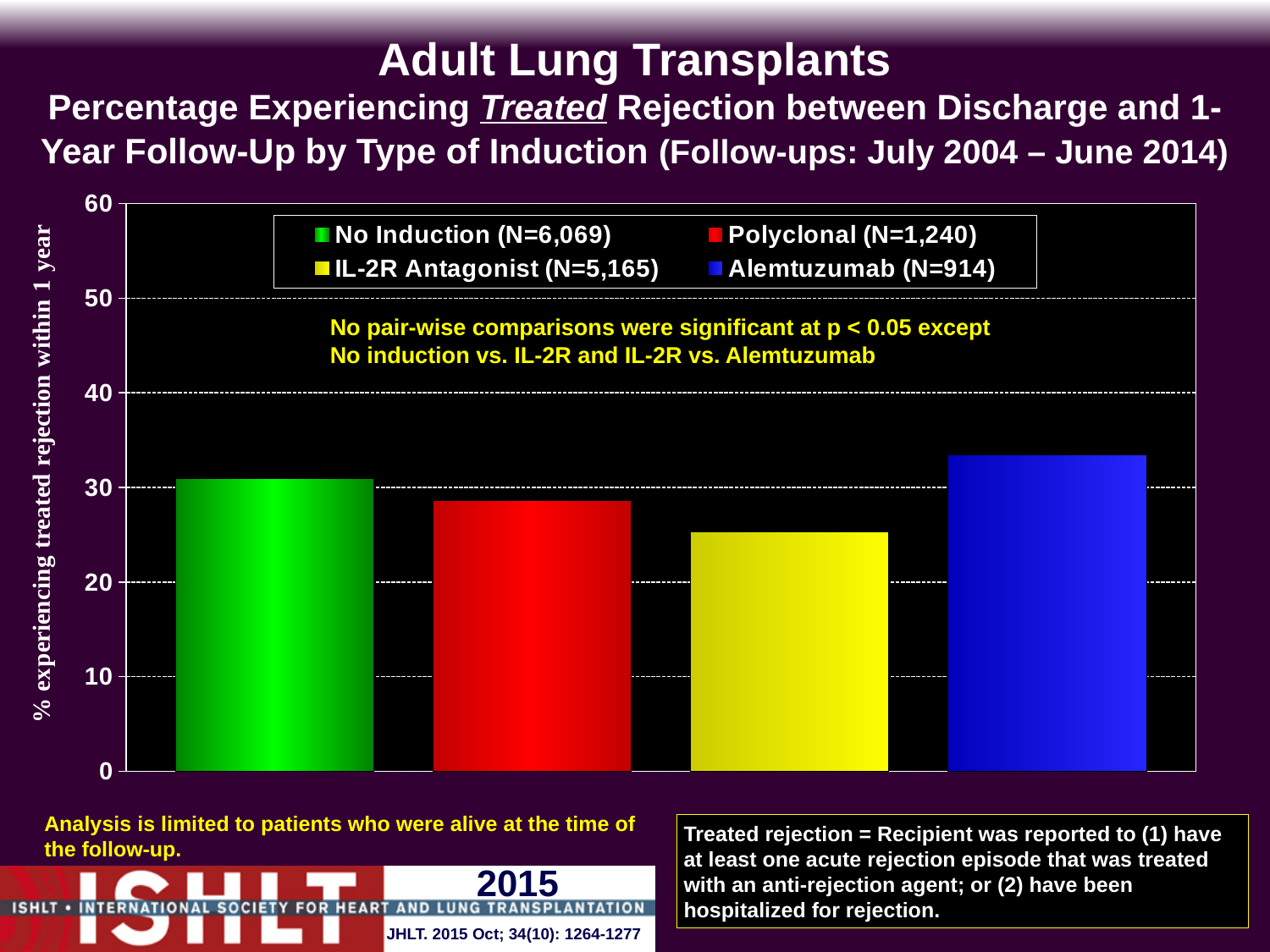
Which is larger, the value for Alemtuzumab or the value for IL-2R Antagonist? Alemtuzumab Which induction type has the lowest percentage experiencing treated rejection within 1 year? IL-2R Antagonist (N=5,165) What colour is the bar for Polyclonal (N=1,240)? red Is the value for Polyclonal greater or less than 30? less Which is larger, the value for Polyclonal or the value for IL-2R Antagonist? Polyclonal Which induction type has the highest percentage experiencing treated rejection within 1 year? Alemtuzumab (N=914) How many series does the legend list? 4 Is the value for Alemtuzumab greater or less than 30? greater Is the value for IL-2R Antagonist greater or less than 20? greater How many bars are plotted in the chart? 4 What kind of chart is shown on the slide? bar chart